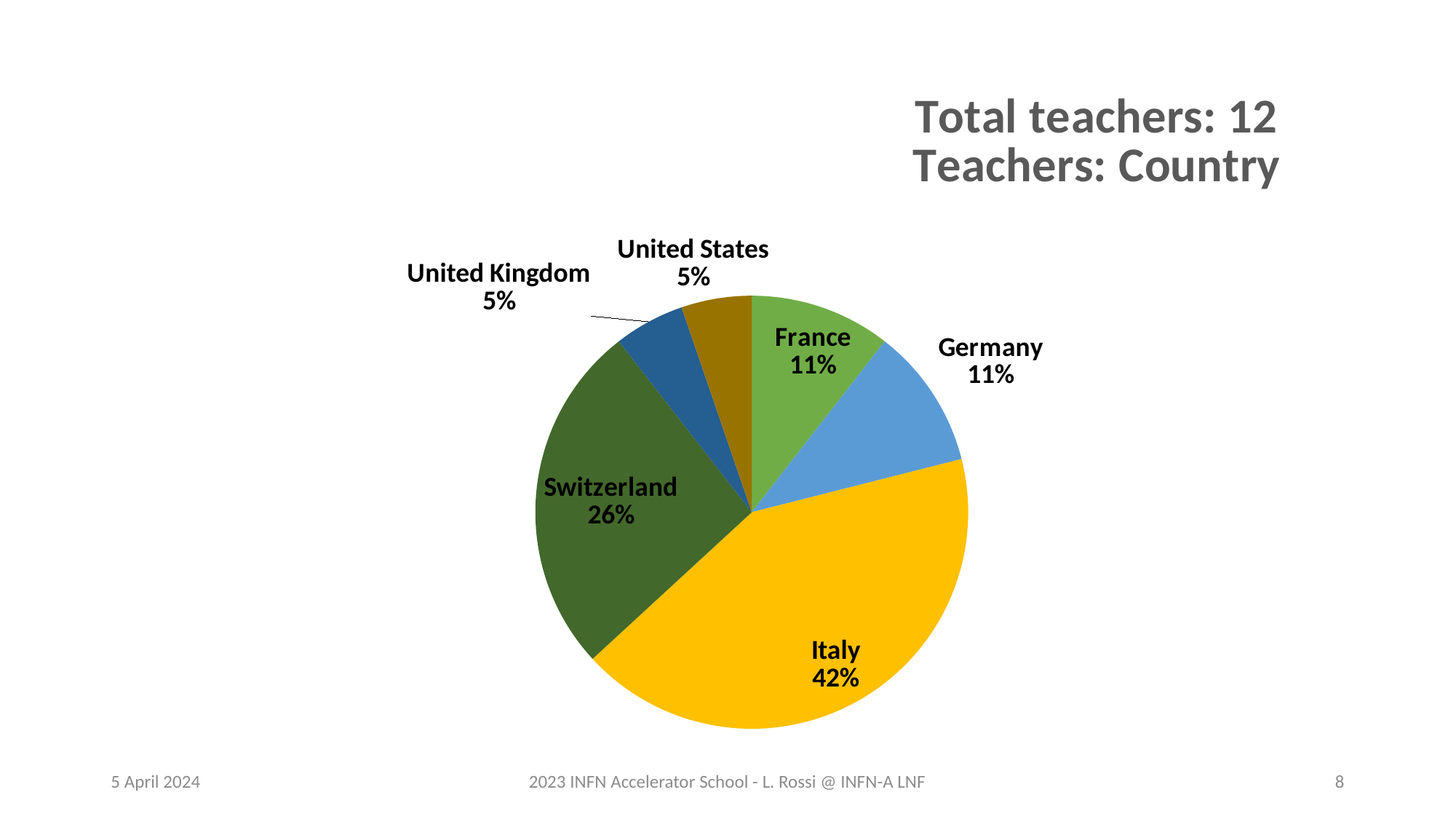
What share of teachers is from Italy? 42% What share of teachers is from Switzerland? 26% What colour is the Italy slice? yellow What kind of chart is shown on the slide? pie chart Which country has the largest share of teachers? Italy What is the difference in percentage points between Italy and Switzerland? 16 What percentage is shown for the United Kingdom? 5% What percentage is shown for France? 11% What is the total number of teachers stated on the slide? 12 What is the difference in percentage points between Germany and the United States? 6 How many countries are shown in the pie chart? 6 Which has a larger share, Switzerland or Germany? Switzerland